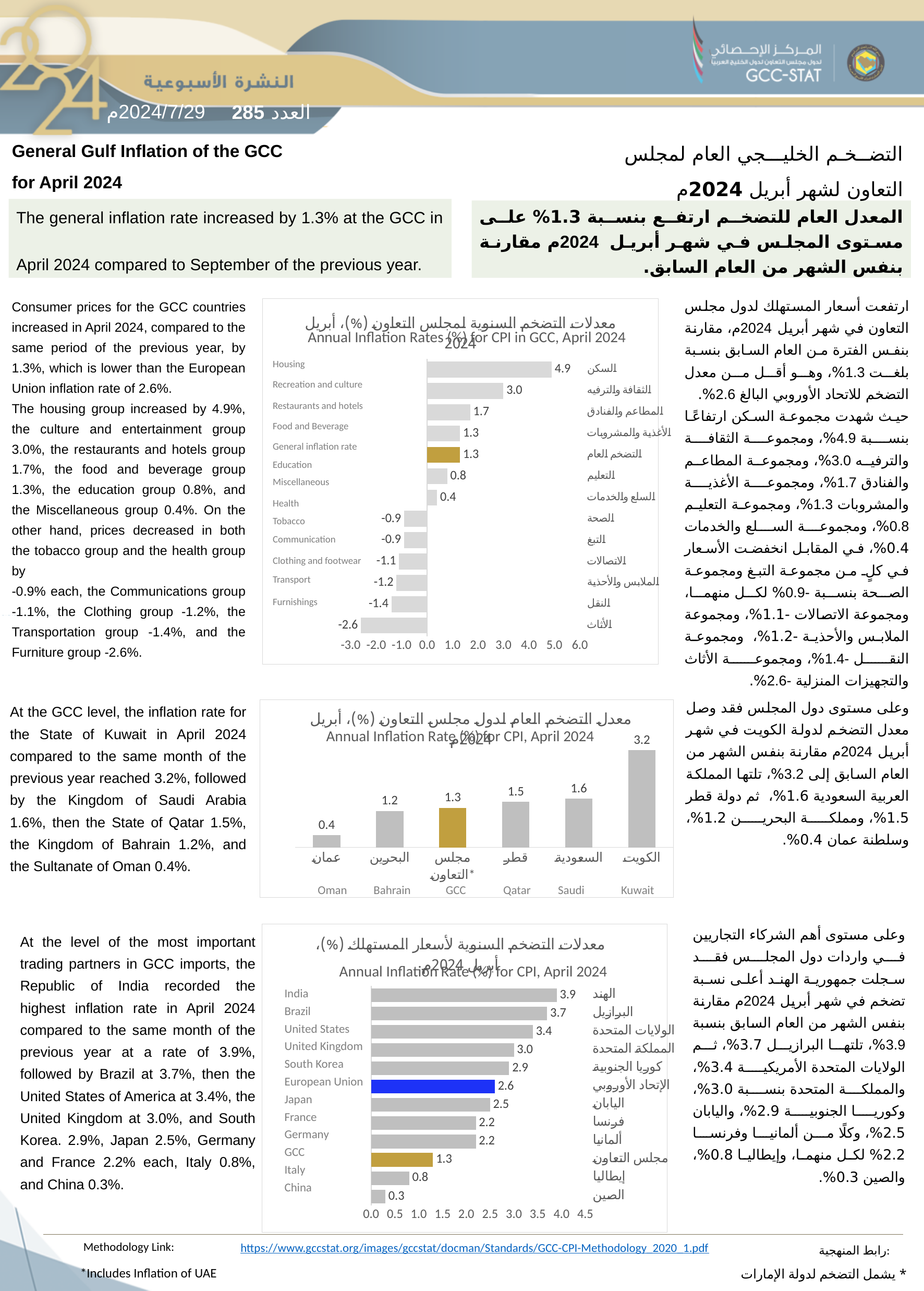
In the top chart, 'Annual Inflation Rates (%) for CPI in GCC, April 2024', what is the value for Transport? -1.4 In the top chart, 'Annual Inflation Rates (%) for CPI in GCC, April 2024', what is the value for Housing? 4.9 In the middle chart, 'Annual Inflation Rate (%) for CPI, April 2024' by country, which country has the highest value? Kuwait In the middle chart, 'Annual Inflation Rate (%) for CPI, April 2024' by country, which is larger, Qatar or Bahrain? Qatar In the top chart, 'Annual Inflation Rates (%) for CPI in GCC, April 2024', which category has the lowest value? Furnishings In the top chart, 'Annual Inflation Rates (%) for CPI in GCC, April 2024', how many categories are plotted? 13 In the middle chart, 'Annual Inflation Rate (%) for CPI, April 2024' by country, what kind of chart is it? Bar chart In the bottom chart, 'Annual Inflation Rate (%) for CPI, April 2024' for trading partners, how many countries or regions are plotted? 12 In the middle chart, 'Annual Inflation Rate (%) for CPI, April 2024' by country, what is the value for Oman? 0.4 In the top chart, 'Annual Inflation Rates (%) for CPI in GCC, April 2024', what is the difference between Housing and Recreation and culture? 1.9 In the bottom chart, 'Annual Inflation Rate (%) for CPI, April 2024' for trading partners, what is the difference between India and China? 3.6 In the bottom chart, 'Annual Inflation Rate (%) for CPI, April 2024' for trading partners, what is the value for the European Union? 2.6